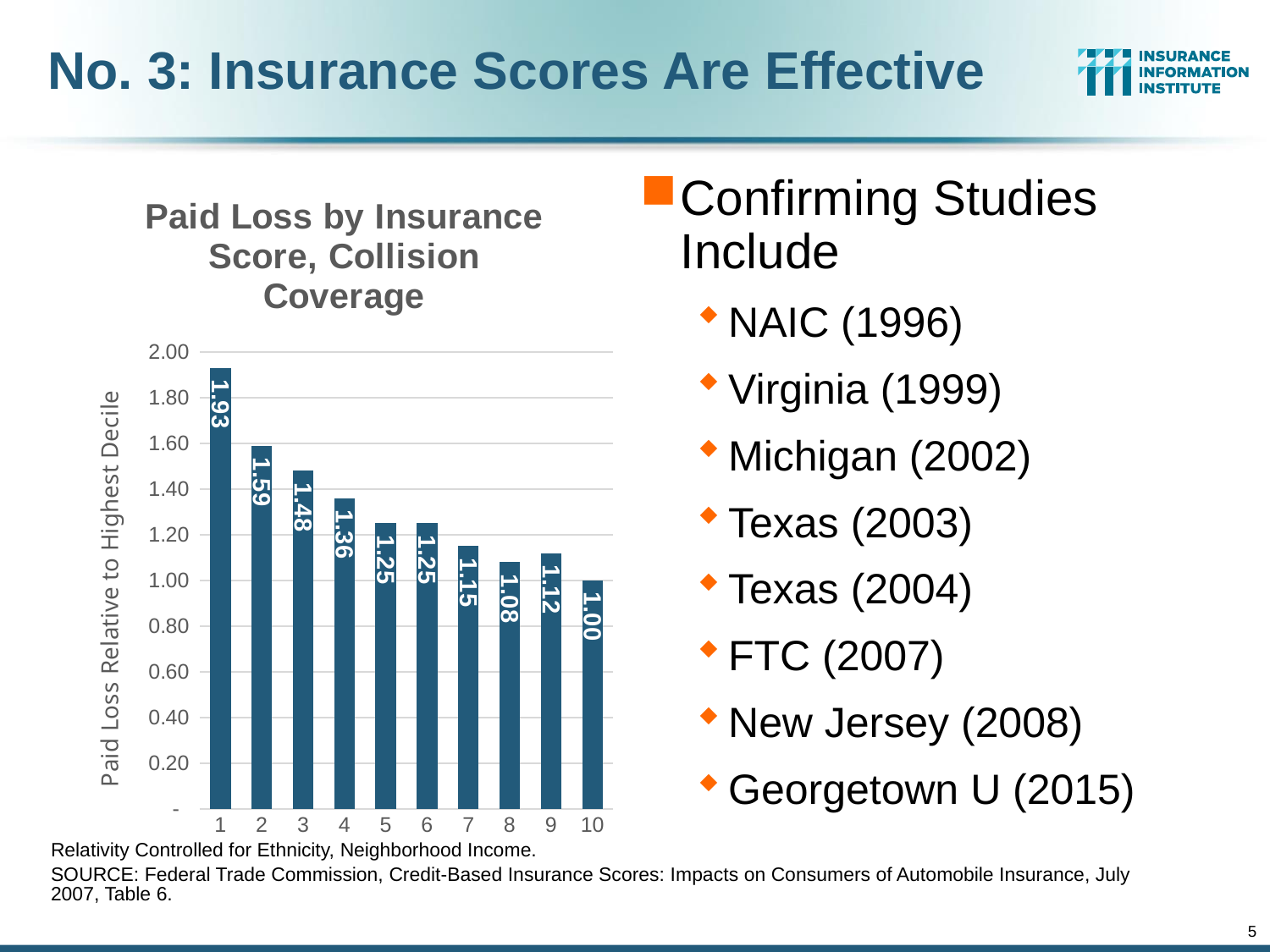
What is the difference between the values for decile 2 and decile 3? 0.11 What is the paid loss relative to highest decile for insurance score decile 1? 1.93 Which decile has the highest paid loss relative to the highest decile? 1 What type of chart is used to show Paid Loss by Insurance Score? Bar chart Do the values generally rise or fall as the insurance score decile increases from 1 to 10? Fall How many deciles are plotted in the chart? 10 What is the difference between the values for decile 1 and decile 10? 0.93 Which decile has the lowest paid loss relative to the highest decile? 10 What is the title of the chart on the slide? Paid Loss by Insurance Score, Collision Coverage What is the value shown for decile 4 in the Paid Loss by Insurance Score chart? 1.36 Which has a larger value, decile 8 or decile 9? Decile 9 What is the value shown for decile 8? 1.08